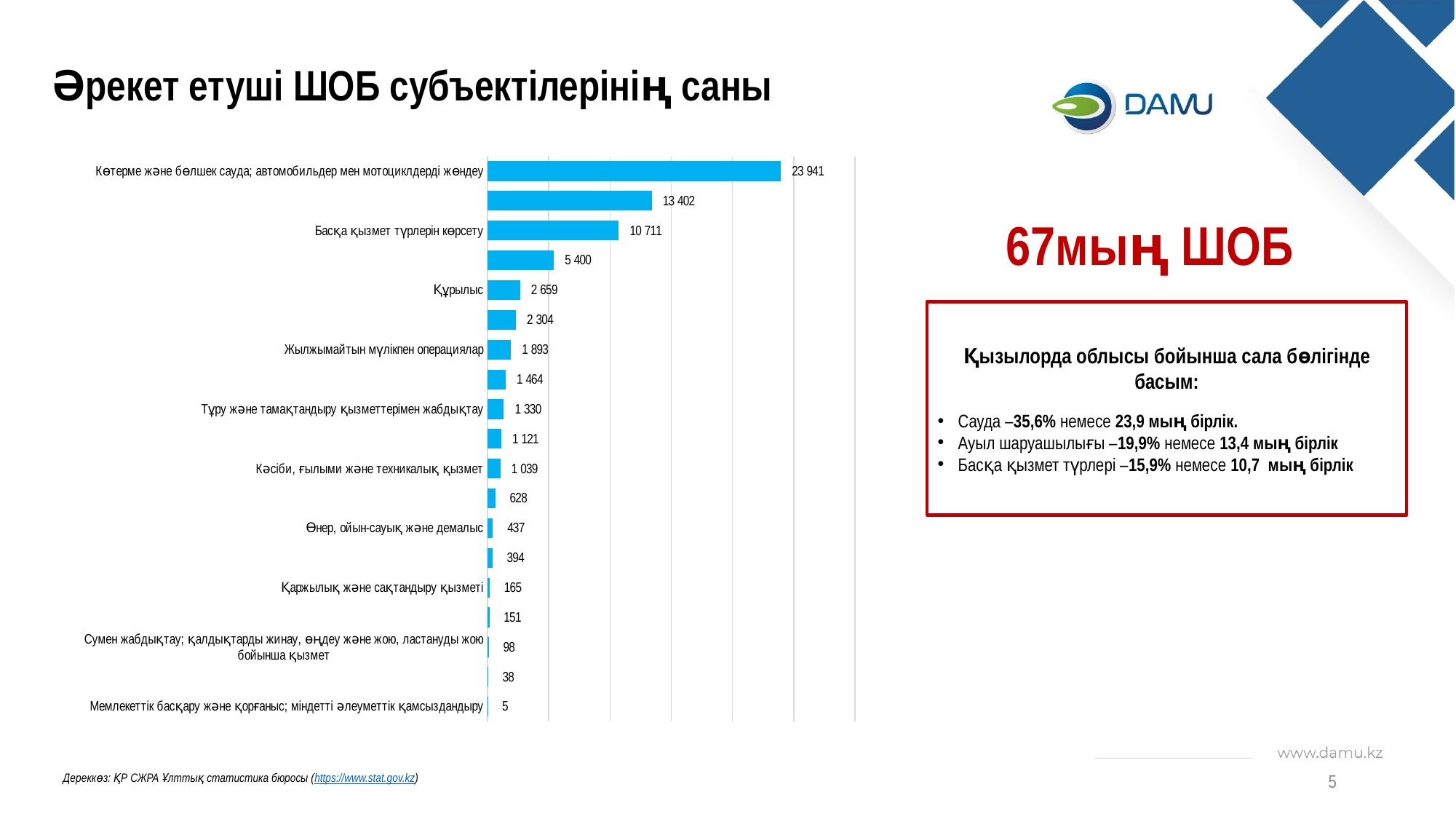
Which is larger: the value for Тұру және тамақтандыру қызметтерімен жабдықтау or the value for Кәсіби, ғылыми және техникалық қызмет? Тұру және тамақтандыру қызметтерімен жабдықтау Do the values rise or fall going from the top bar to the bottom bar? fall What is the title of the slide containing the chart? Әрекет етуші ШОБ субъектілерінің саны What kind of chart is shown on the slide? bar chart What is the value for Құрылыс? 2 659 Which category has the lowest value? Мемлекеттік басқару және қорғаныс; міндетті әлеуметтік қамсыздандыру How many bars does the chart have? 19 What is the value for Басқа қызмет түрлерін көрсету? 10 711 What is the value for Өнер, ойын-сауық және демалыс? 437 Which category has the highest value? Көтерме және бөлшек сауда; автомобильдер мен мотоциклдерді жөндеу What is the value for Жылжымайтын мүлікпен операциялар? 1 893 What is the difference between the values for Көтерме және бөлшек сауда; автомобильдер мен мотоциклдерді жөндеу and Басқа қызмет түрлерін көрсету? 13 230